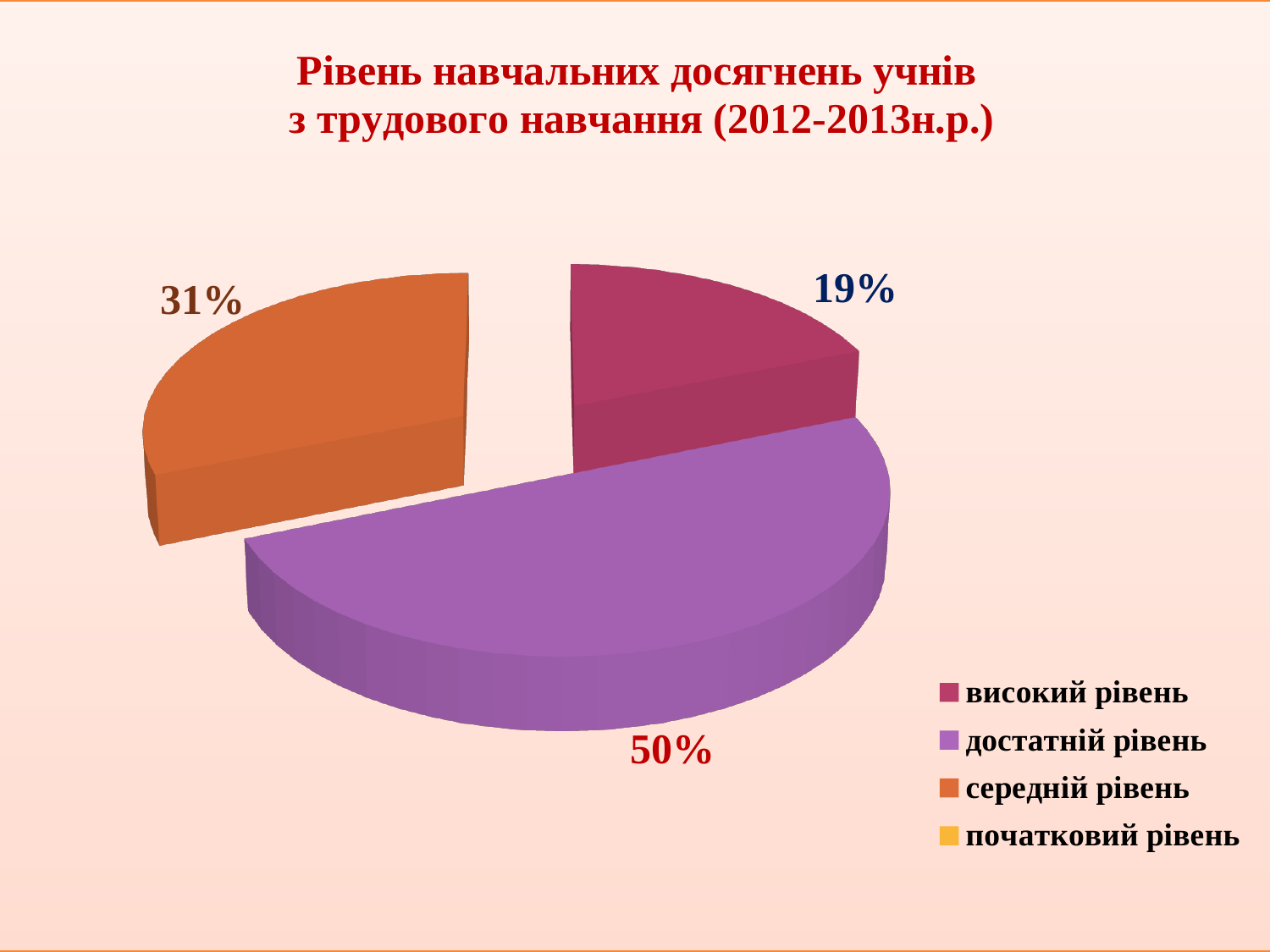
What percentage of the pie is labelled for достатній рівень? 50% Which of the labelled slices is the smallest? високий рівень What colour is the slice for середній рівень? orange How many slices of the pie have a percentage label? 3 What percentage is shown for високий рівень? 19% Which is larger, the slice for середній рівень or the slice for високий рівень? середній рівень What is the difference in percentage points between середній рівень and високий рівень? 12 How many entries does the legend list? 4 What is the difference in percentage points between достатній рівень and високий рівень? 31 What kind of chart is shown on the slide? pie chart What percentage is shown for середній рівень? 31% Which level has the largest slice of the pie? достатній рівень